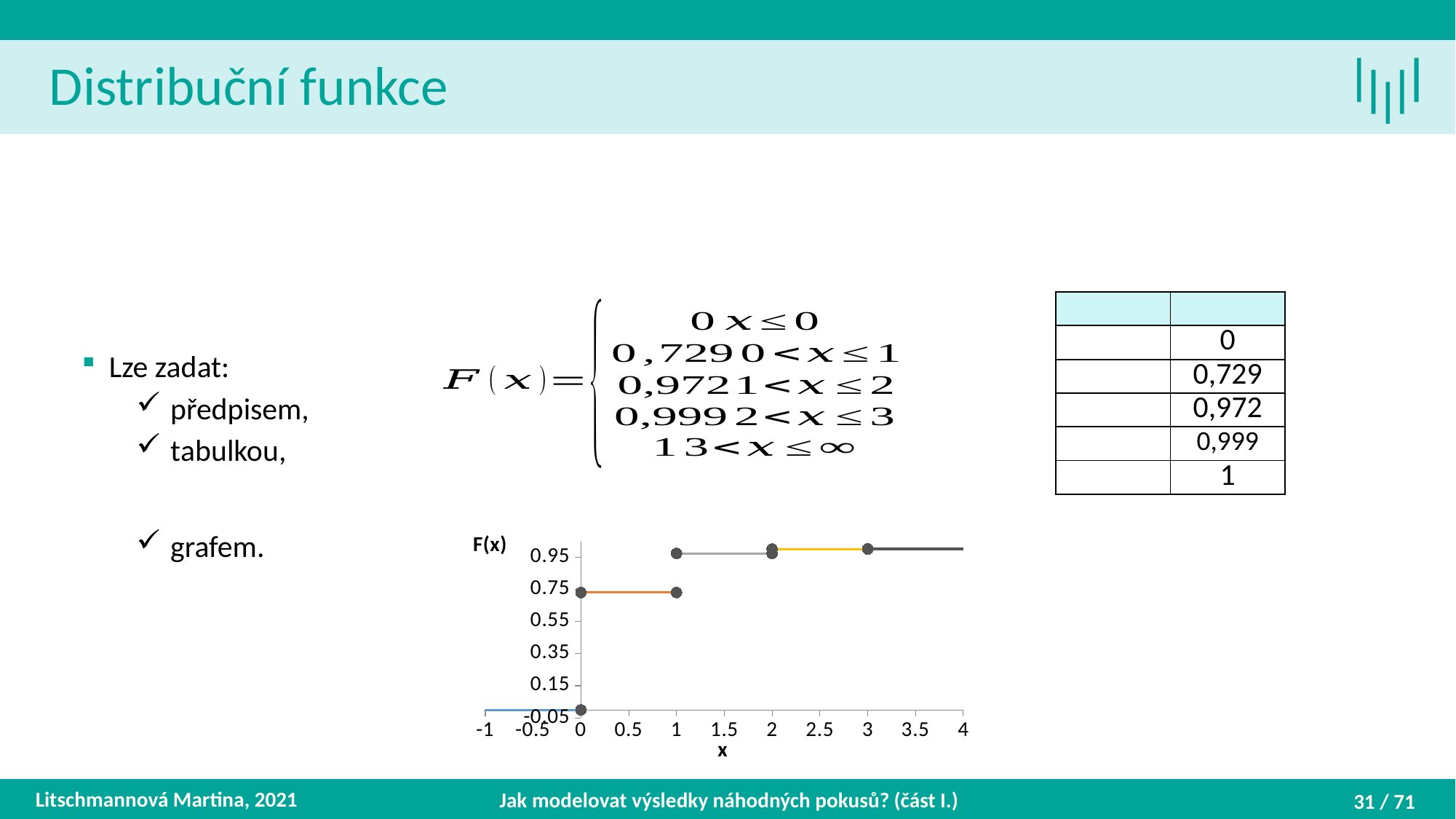
Which is larger, the value of F(x) at x = 0.5 or at x = 2.5? x = 2.5 How many horizontal line segments make up the plotted step function? 5 Is the value of F(x) at x = -0.5 greater or less than 0.15? less What is the label of the vertical axis of the chart? F(x) Is the value of F(x) at x = 0.5 greater or less than 0.95? less Is the value of F(x) at x = 1.5 greater or less than 0.75? greater What kind of chart is shown on the slide? line chart What is the lowest tick value shown on the x axis? -1 Do the values of F(x) rise or fall as x increases along the x axis? rise What is the label of the horizontal axis of the chart? x What is the highest tick value shown on the x axis? 4